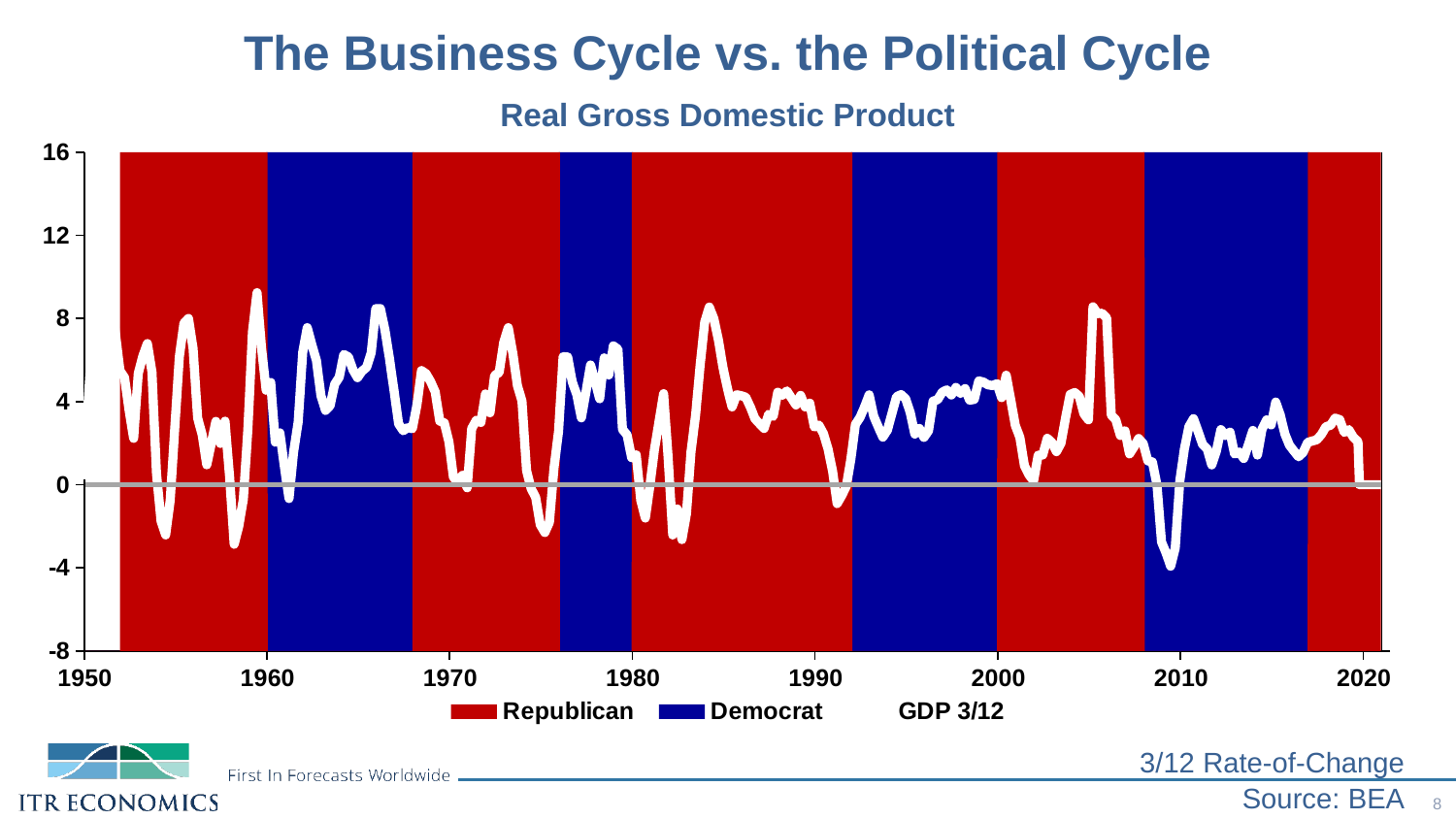
Is the value of the GDP 3/12 line around 2009 greater or less than 0? less Between 2005 and 2009, does the GDP 3/12 line rise or fall? fall What is the subtitle of the chart? Real Gross Domestic Product Which is larger, the value of the GDP 3/12 line around 1984 or around 2009? around 1984 How many entries does the legend list? 3 Between 2009 and 2011, does the GDP 3/12 line rise or fall? rise Which colour of shading represents Democrat periods? blue Around which year does the GDP 3/12 line reach its lowest value? 2009 How many blue (Democrat) shaded periods are there on the chart? 4 Is the value of the GDP 3/12 line around 1975 greater or less than 0? less Is the value of the GDP 3/12 line around 1984 greater or less than 4? greater What kind of chart is shown on the slide? line chart